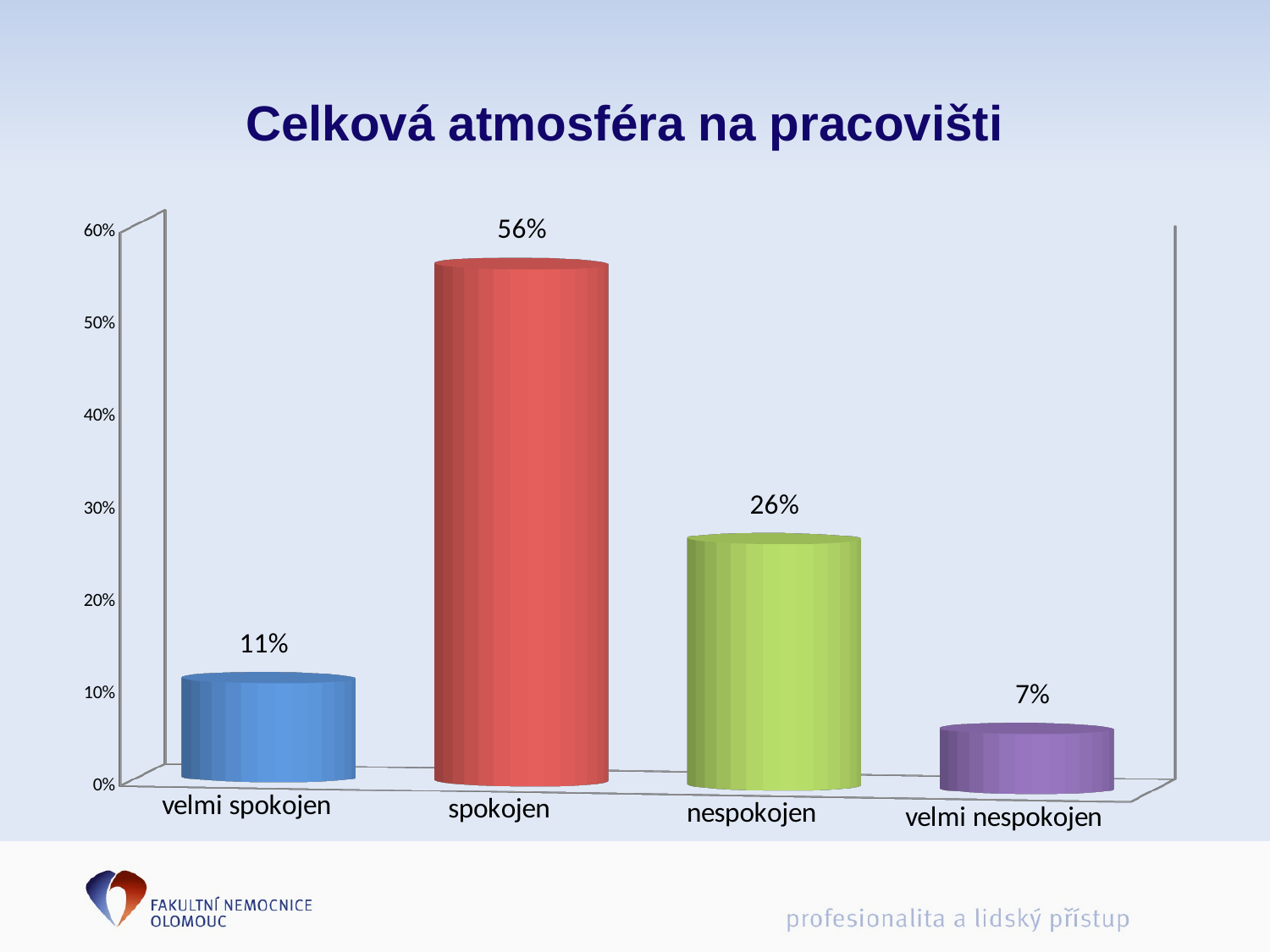
How many categories are shown on the x axis? 4 Which category has the lowest value? velmi nespokojen What is the value for "velmi spokojen"? 11% What is the value for "nespokojen"? 26% Which is larger, the value for "velmi spokojen" or the value for "nespokojen"? nespokojen What kind of chart is shown on the slide? bar chart Which category has the highest value? spokojen What is the value for "velmi nespokojen"? 7% What is the title of the chart? Celková atmosféra na pracovišti What is the value for "spokojen"? 56% What is the difference between the values for "spokojen" and "nespokojen"? 30% What is the difference between the values for "velmi spokojen" and "velmi nespokojen"? 4%